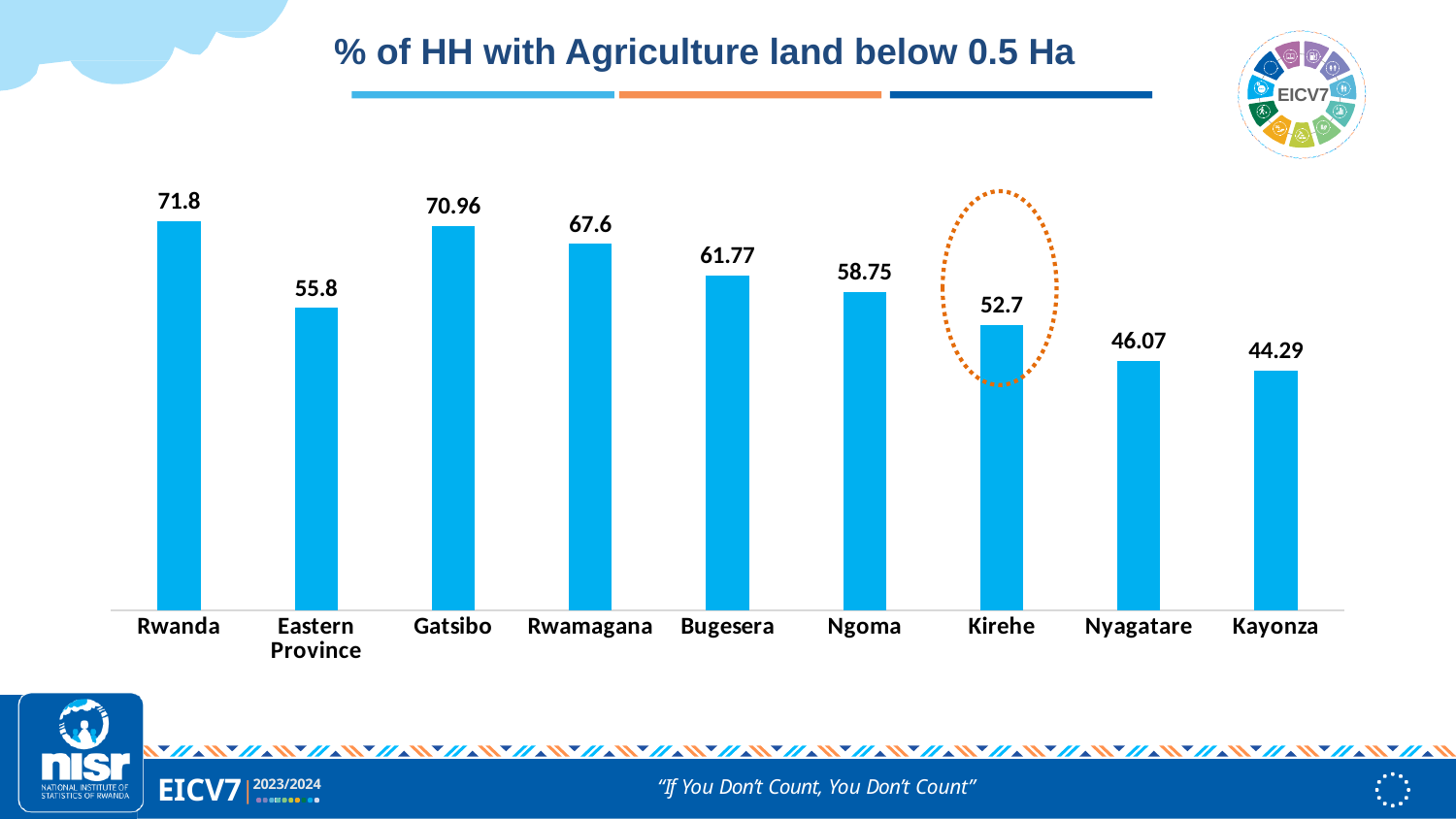
What is the value for Eastern Province? 55.8 Which category has the lowest value? Kayonza What is the title of the chart? % of HH with Agriculture land below 0.5 Ha What kind of chart is shown on the slide? Bar chart What is the difference between the values for Rwanda and Kayonza? 27.51 What is the difference between the values for Bugesera and Ngoma? 3.02 What is the value for Gatsibo? 70.96 Which is larger, the value for Rwamagana or the value for Nyagatare? Rwamagana How many categories are shown on the chart? 9 Which category has the highest value? Rwanda What is the value for Kirehe? 52.7 Which category's bar is highlighted with a dotted orange circle? Kirehe